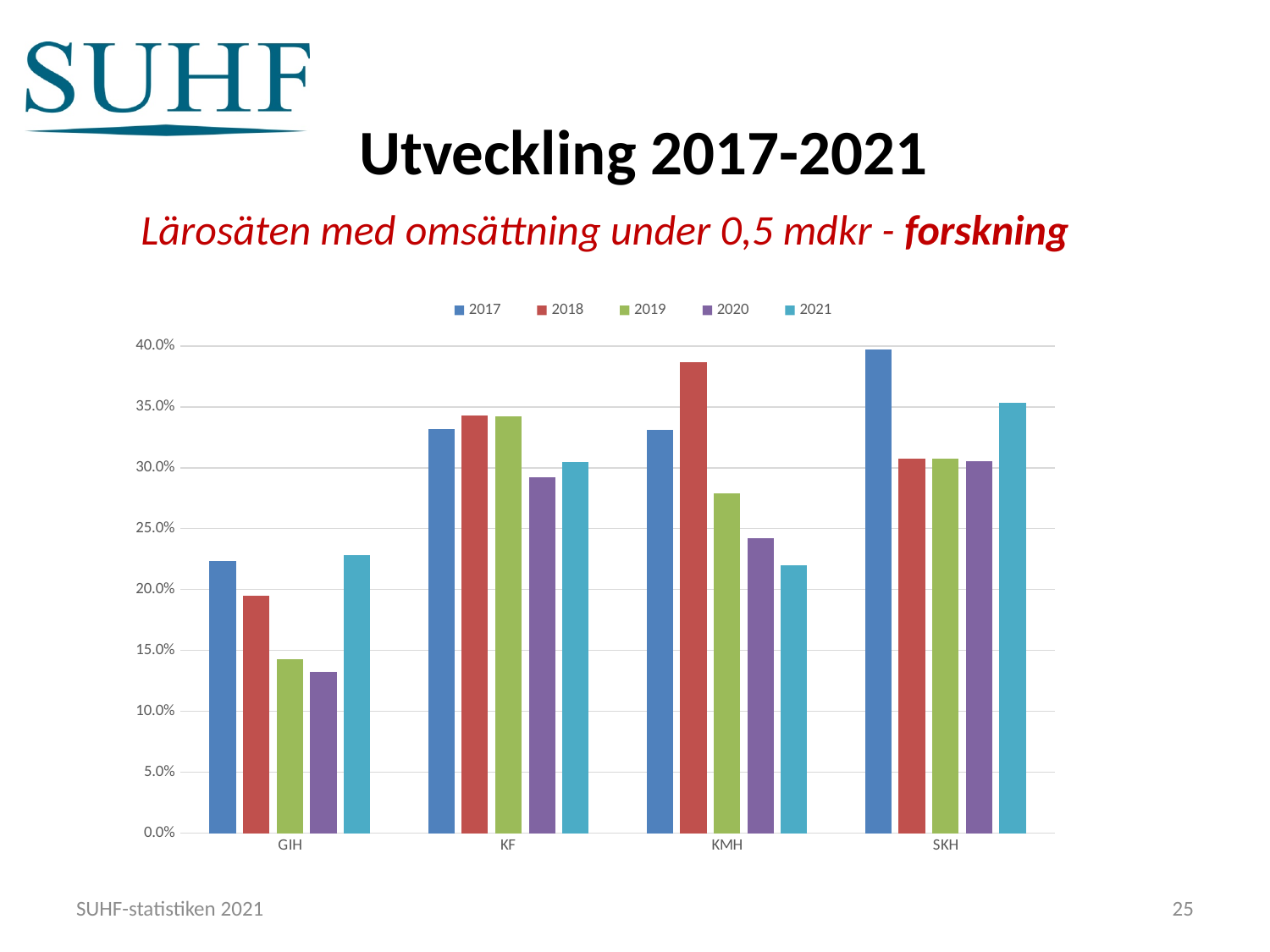
Is the 2019 value for GIH greater or less than 15.0%? less What kind of chart is shown on the slide? bar chart Which institution has the highest value for 2017? SKH For KMH, do the values rise or fall from 2018 to 2021? fall Is the 2018 value for KMH greater or less than 35.0%? greater How many categories (institutions) are shown on the x axis? 4 Which institution has the lowest value for 2020? GIH Is the 2017 value for SKH greater or less than 35.0%? greater For GIH, which is larger: the 2017 value or the 2018 value? 2017 For KMH, which is larger: the 2018 value or the 2021 value? 2018 Which years are listed in the chart legend? 2017, 2018, 2019, 2020, 2021 How many series does the legend list? 5